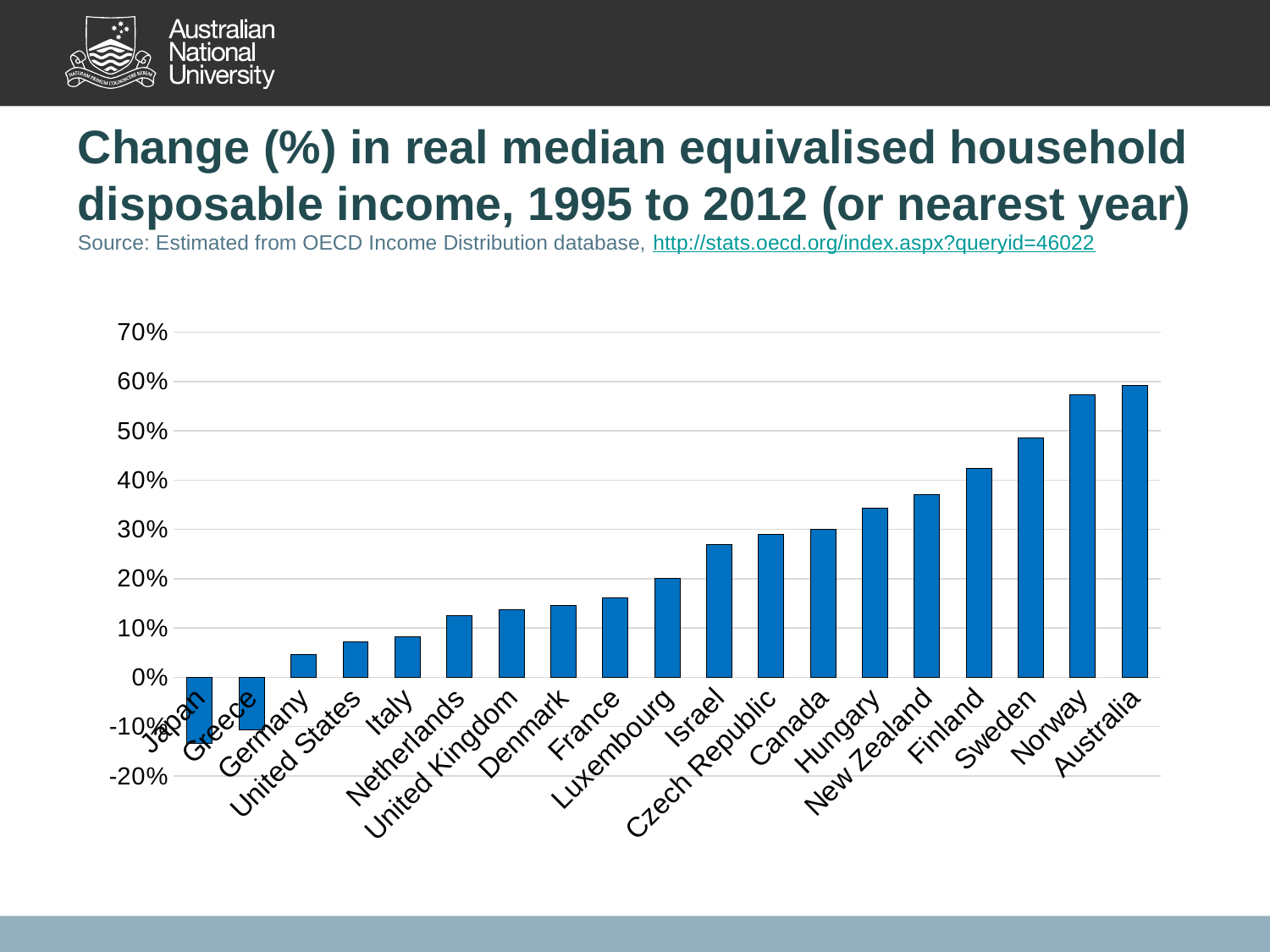
Which has a larger value, Norway or Sweden? Norway What period does the chart title say the change in income covers? 1995 to 2012 (or nearest year) What kind of chart is shown on the slide? Bar chart Is the value for Hungary greater or less than 30%? greater Which country has the highest change in real median equivalised household disposable income? Australia How many countries are shown on the chart? 19 Which country has the lowest change in real median equivalised household disposable income? Japan Is the value for Sweden greater or less than 50%? less Is the value for Germany greater or less than 10%? less Do the values generally rise or fall moving from left to right along the x axis? Rise